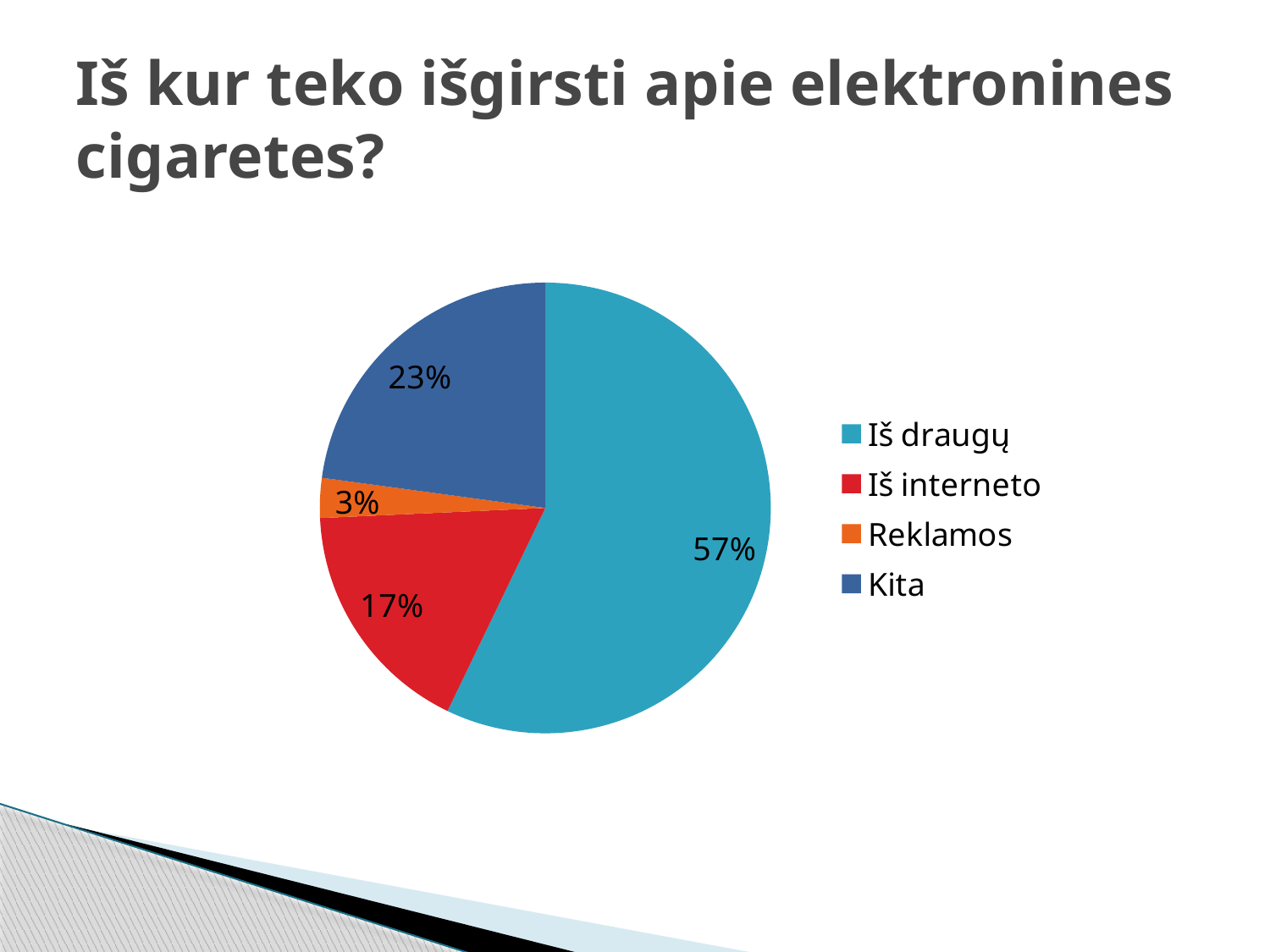
What is the difference in percentage points between "Iš interneto" and "Reklamos"? 14 What share of the pie does "Iš draugų" represent? 57% What kind of chart is shown on the slide? Pie chart What share of the pie does "Kita" represent? 23% What share of the pie does "Iš interneto" represent? 17% How many categories does the pie chart show? 4 What colour is the slice for "Reklamos"? Orange Which category has the largest slice of the pie? Iš draugų What is the difference in percentage points between "Iš draugų" and "Kita"? 34 Which category has the smallest slice of the pie? Reklamos Which is larger, the slice for "Kita" or the slice for "Iš interneto"? Kita